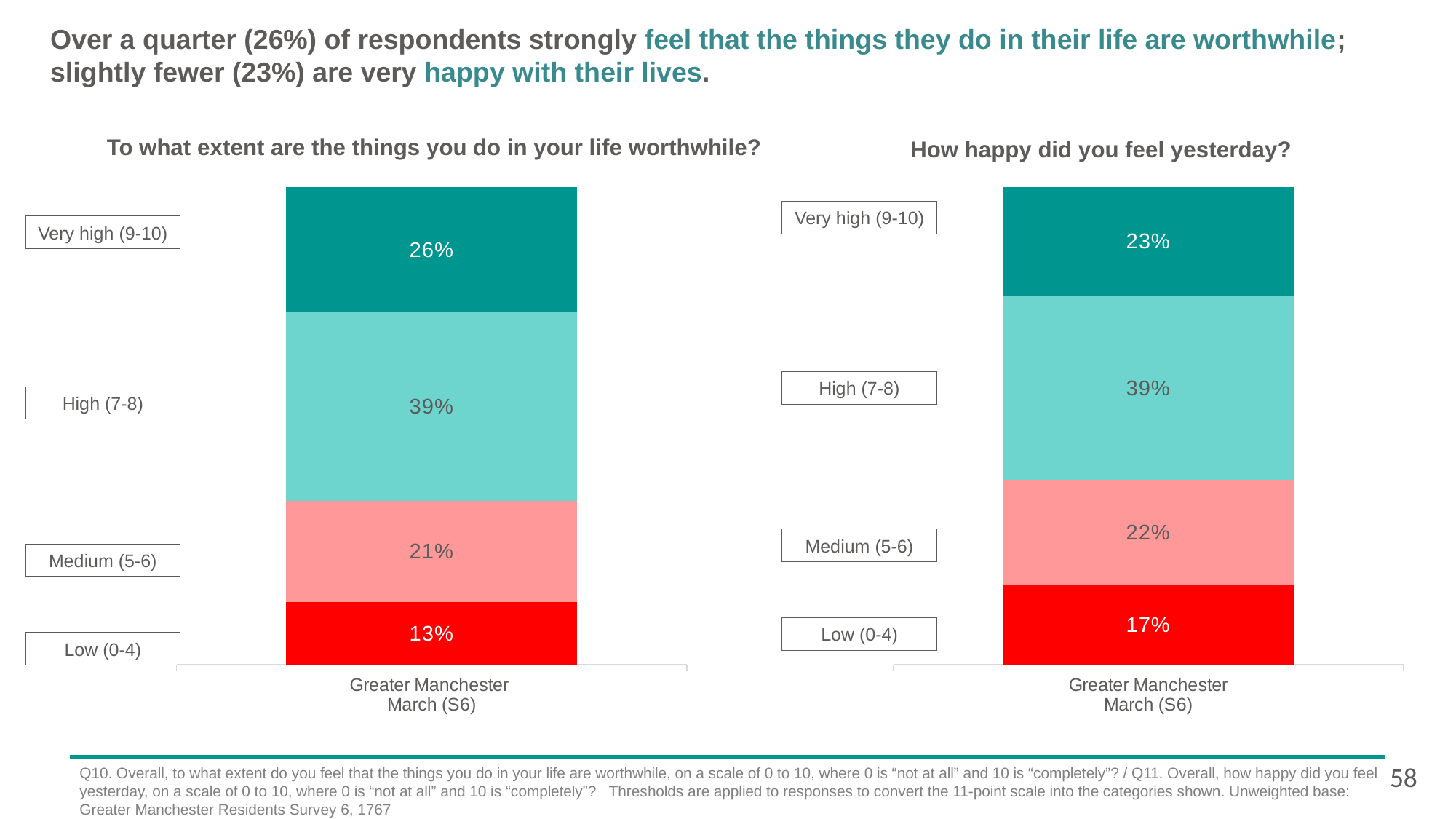
In the chart 'How happy did you feel yesterday?', what percentage of respondents are in the Low (0-4) category? 17% Which is larger: the Low (0-4) share in the 'worthwhile' chart or the Low (0-4) share in the 'happy yesterday' chart? The 'happy yesterday' chart (17%) What type of chart is used on this slide? Stacked bar chart In the chart 'To what extent are the things you do in your life worthwhile?', which category has the largest share? High (7-8) In the chart 'How happy did you feel yesterday?', what is the difference between the Very high (9-10) and Low (0-4) percentages? 6% In the chart 'To what extent are the things you do in your life worthwhile?', which category has the smallest share? Low (0-4) In the chart 'To what extent are the things you do in your life worthwhile?', what is the difference between the High (7-8) and Medium (5-6) percentages? 18% In the chart 'To what extent are the things you do in your life worthwhile?', how many categories make up the stacked bar? 4 In the chart 'How happy did you feel yesterday?', what is the label on the x axis under the bar? Greater Manchester March (S6) In the chart 'How happy did you feel yesterday?', what percentage of respondents are in the Medium (5-6) category? 22% In the chart 'How happy did you feel yesterday?', which category has the smallest share? Low (0-4) In the chart 'To what extent are the things you do in your life worthwhile?', what percentage of respondents are in the Very high (9-10) category? 26%